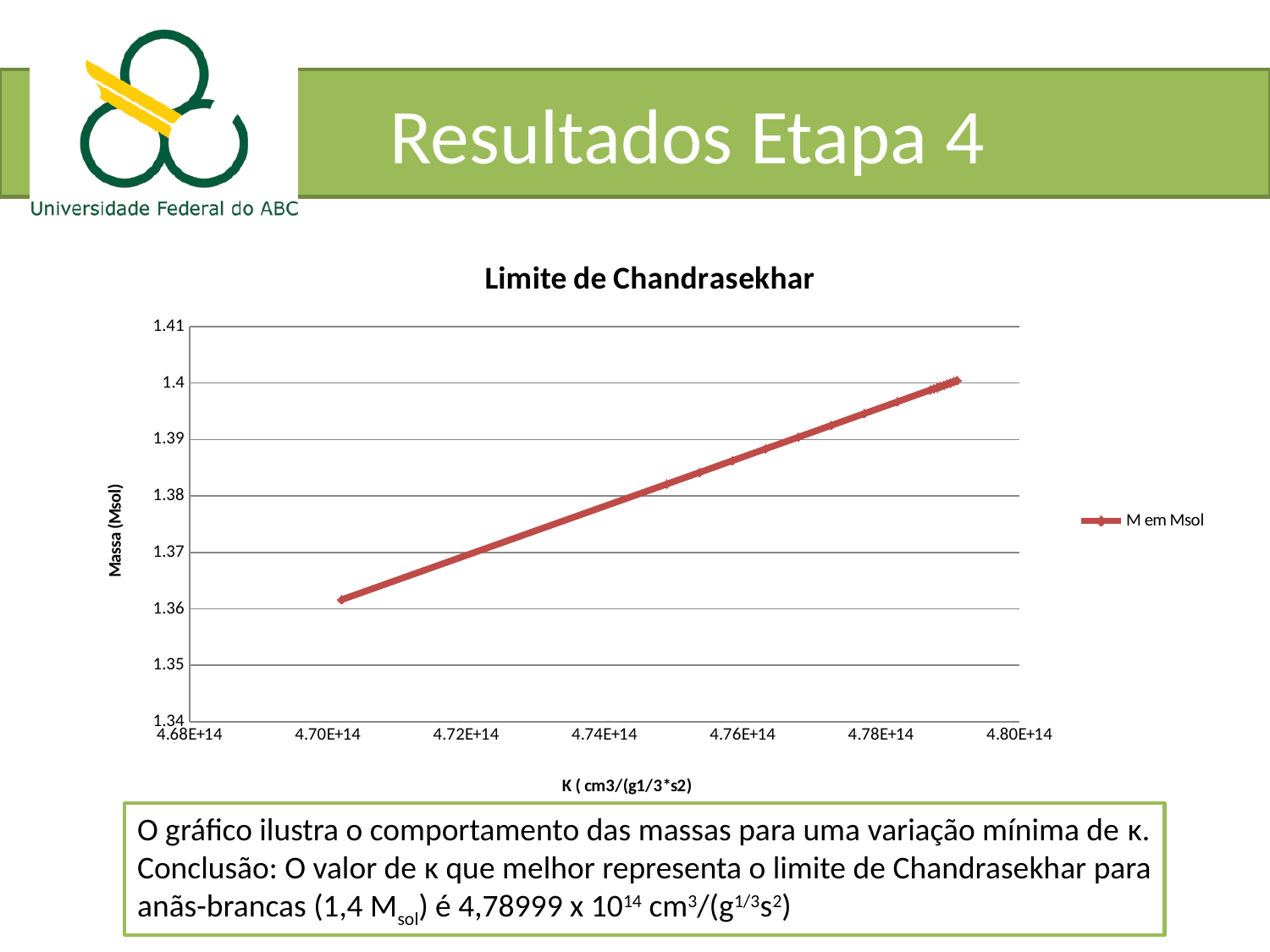
What is the name of the series shown in the legend? M em Msol What kind of chart is shown on the slide? line chart Is the lowest plotted value of M em Msol greater or less than 1.35? greater Is the highest plotted value of M em Msol greater or less than 1.41? less Is the value of M em Msol at K = 4.78E+14 greater or less than 1.39? greater What is the title of the chart? Limite de Chandrasekhar Does the mass (Massa) rise or fall as K increases along the x axis? rise How many series does the chart legend list? 1